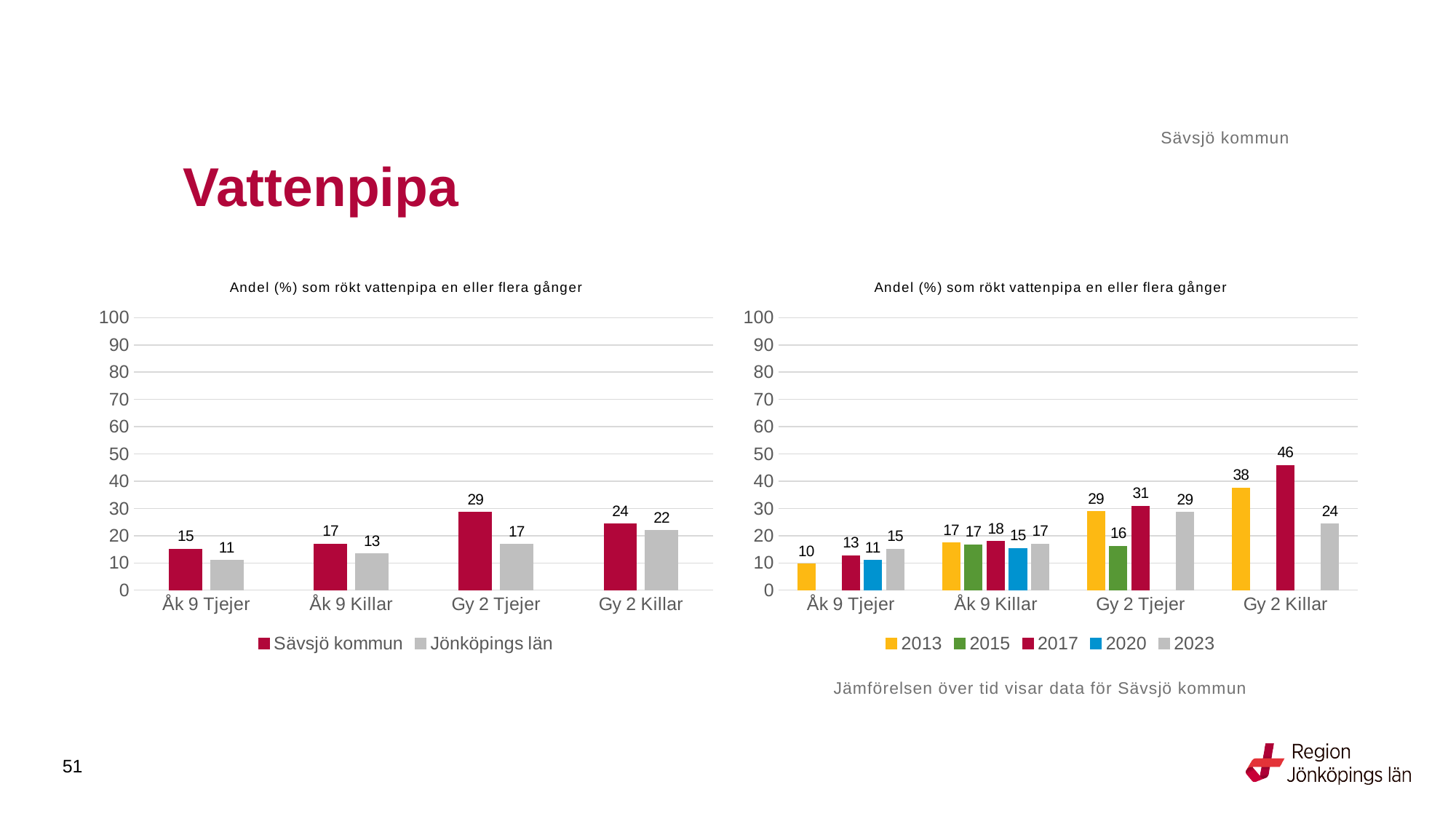
In the left chart, what is the value for Jönköpings län for Åk 9 Killar? 13 In the right chart, which year has the lowest value for Åk 9 Tjejer? 2013 In the left chart, how many series does the legend list? 2 What type of chart is the left chart? Bar chart In the left chart, which category has the highest value for Sävsjö kommun? Gy 2 Tjejer In the right chart, what is the value for 2017 for Gy 2 Killar? 46 In the right chart, what is the difference between the 2017 and 2023 values for Gy 2 Killar? 22 In the right chart, what is the value for 2015 for Gy 2 Tjejer? 16 In the left chart, what is the value for Sävsjö kommun for Gy 2 Tjejer? 29 In the left chart, what is the difference between Sävsjö kommun and Jönköpings län for Gy 2 Tjejer? 12 In the right chart, how many series does the legend list? 5 In the right chart, which is larger for Gy 2 Killar: 2013 or 2023? 2013